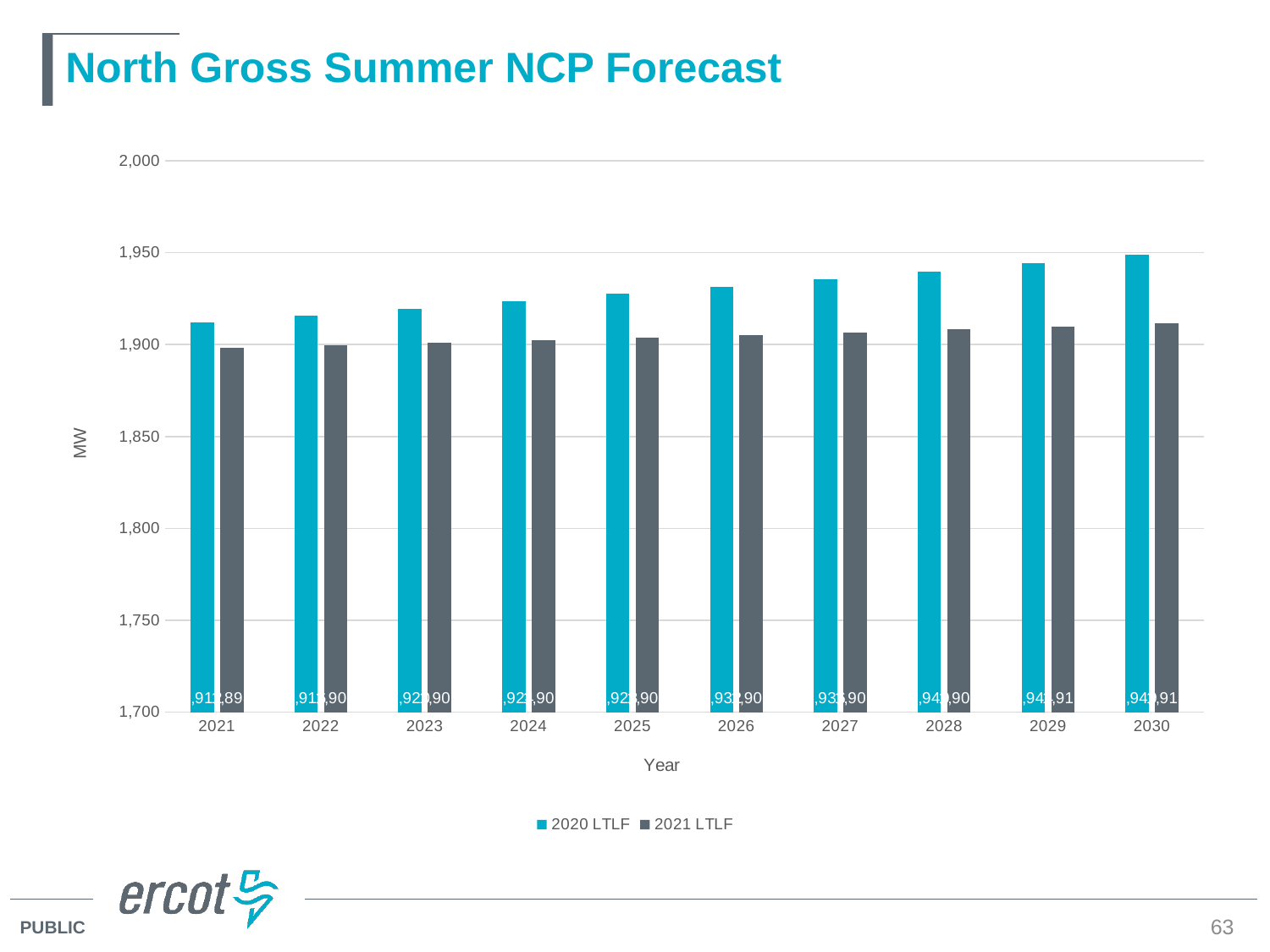
How many series does the legend list? 2 In 2025, which series has the larger value, 2020 LTLF or 2021 LTLF? 2020 LTLF Is the 2020 LTLF value for 2021 greater or less than 1,900? greater What kind of chart is shown on the slide? bar chart Is the 2021 LTLF value for 2030 greater or less than 1,900? greater Which year has the lowest 2021 LTLF value? 2021 Which year has the highest 2021 LTLF value? 2030 Which year has the lowest 2020 LTLF value? 2021 Do the 2020 LTLF values rise or fall from 2021 to 2030? rise Is the 2020 LTLF value for 2021 greater or less than 1,950? less Which year has the highest 2020 LTLF value? 2030 How many years are shown on the x axis? 10